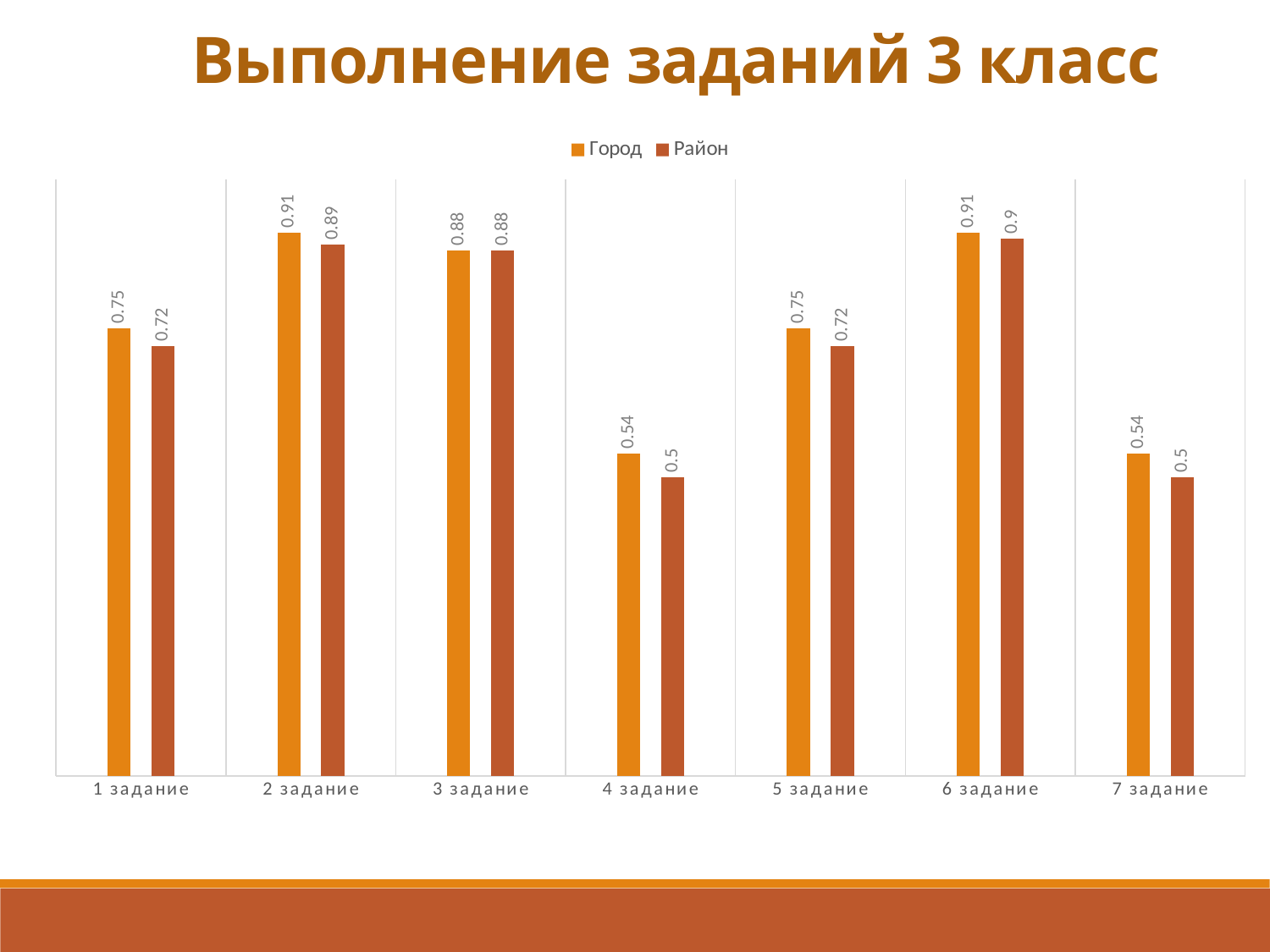
What is the value for Город for 1 задание? 0.75 Which is larger for 5 задание, Город or Район? Город What is the value for Город for 3 задание? 0.88 How many tasks (categories) are shown on the x axis? 7 What is the value for Район for 4 задание? 0.5 What is the difference between Город and Район for 2 задание? 0.02 What is the value for Район for 6 задание? 0.9 How many series does the legend list? 2 For which task does Район have its highest value? 6 задание What is the title of the slide? Выполнение заданий 3 класс What kind of chart is shown on the slide? Bar chart What is the difference between Город and Район for 4 задание? 0.04